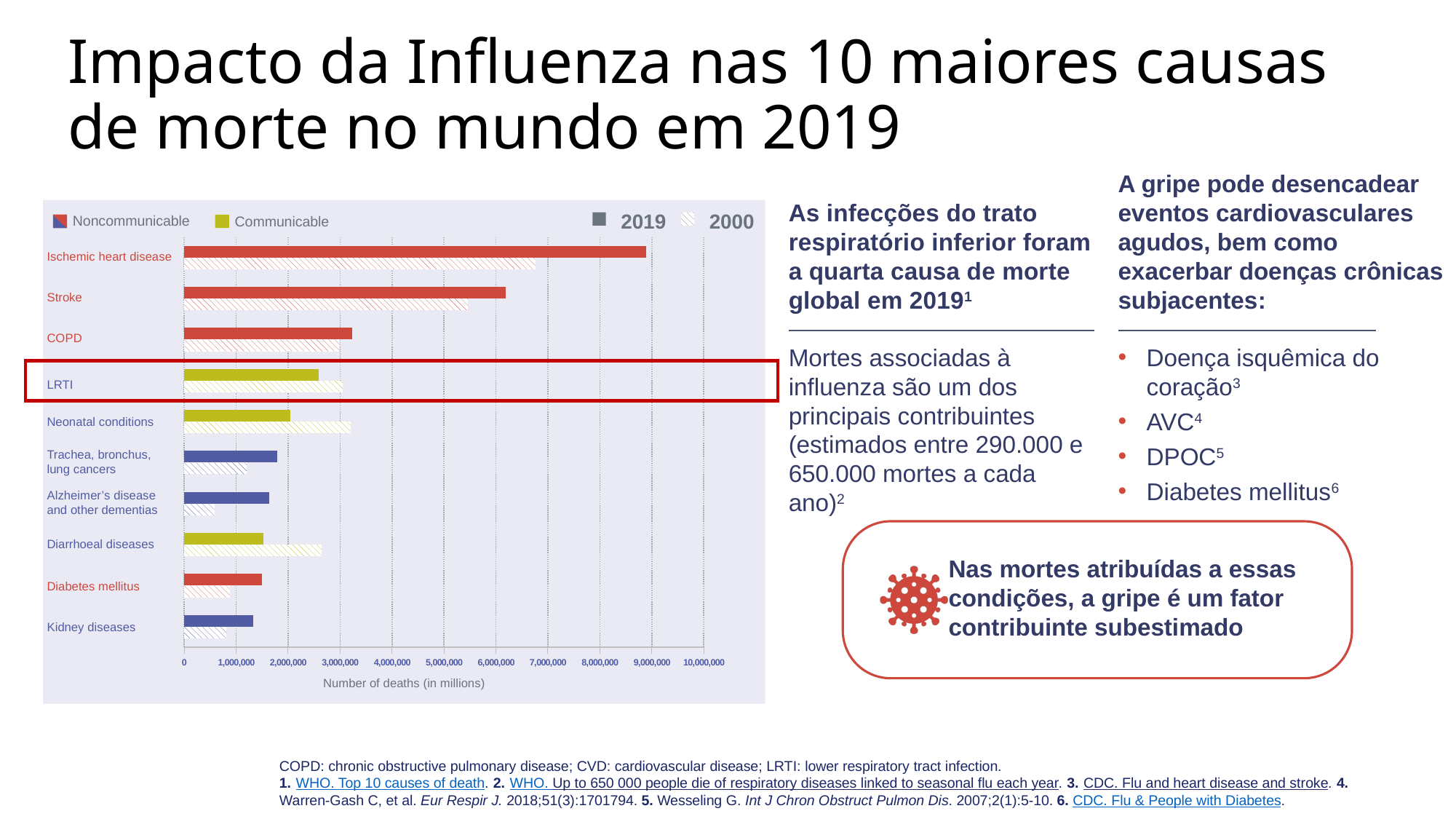
Which cause of death is highlighted with a red box on the chart? LRTI For Diabetes mellitus, which year shows more deaths, 2019 or 2000? 2019 Is the 2019 value for COPD greater or less than 3,000,000? greater Which cause of death has the highest number of deaths in 2019? Ischemic heart disease Is the 2019 value for Ischemic heart disease greater or less than 8,000,000? greater For LRTI, which year shows more deaths, 2019 or 2000? 2000 What is the label of the chart's horizontal axis? Number of deaths (in millions) Which two years does the chart's legend compare? 2019 and 2000 Is the 2000 value for Neonatal conditions greater or less than 3,000,000? greater What kind of chart is shown on the slide? Bar chart How many causes of death are listed on the chart? 10